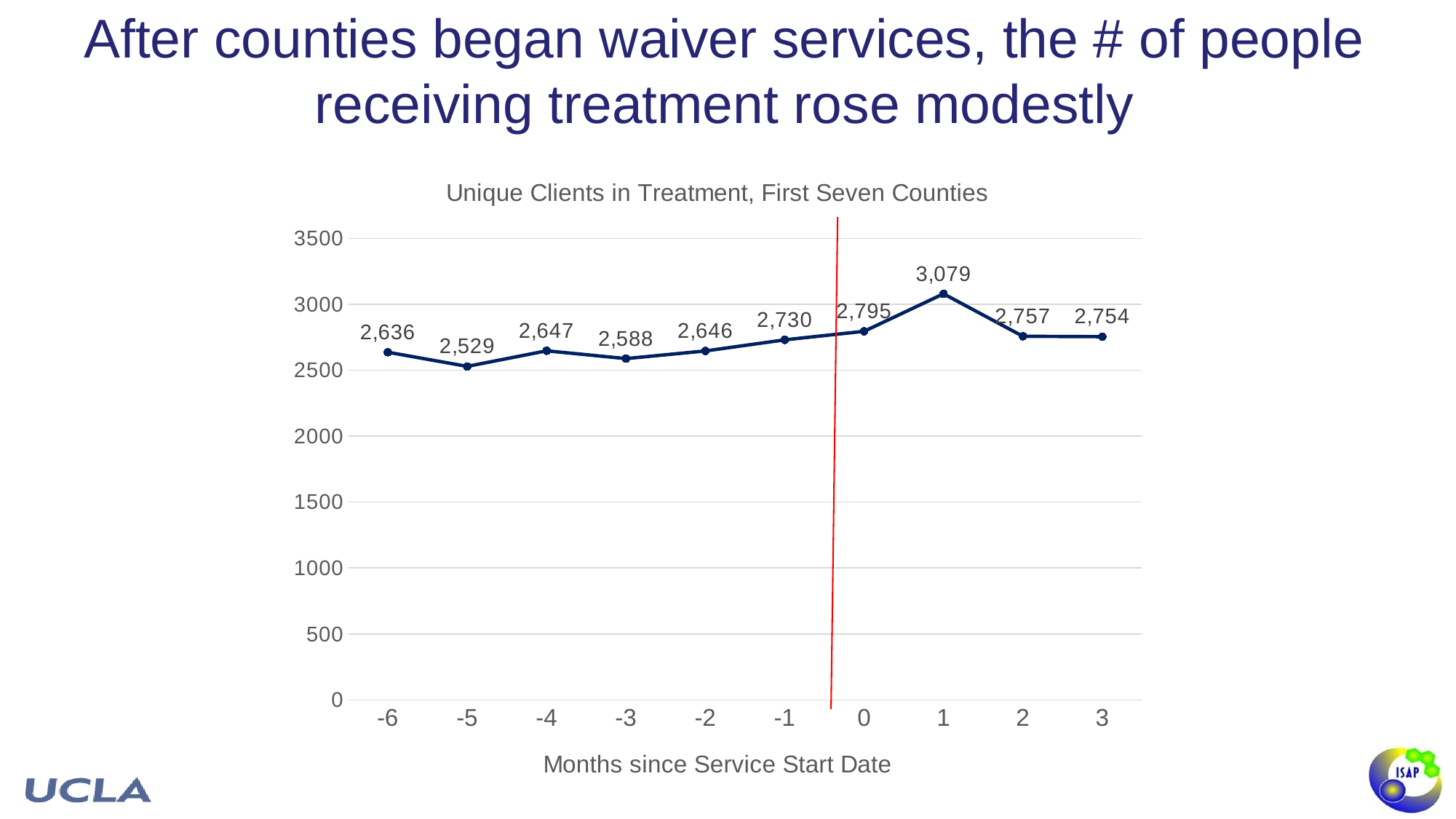
What is the difference between the number of clients at month -6 and at month -5? 107 What is the number of unique clients in treatment at month 0? 2,795 What is the number of unique clients in treatment at month 3? 2,754 What is the number of unique clients in treatment at month -6? 2,636 At which month is the number of unique clients in treatment lowest? -5 At which month is the number of unique clients in treatment highest? 1 Which is larger, the number of clients at month -1 or at month -3? -1 What kind of chart is shown on the slide? Line chart What is the title of the chart? Unique Clients in Treatment, First Seven Counties Is the value at month 1 greater or less than 3000? greater What is the difference between the number of clients at month 1 and at month 0? 284 How many data points are plotted on the chart? 10